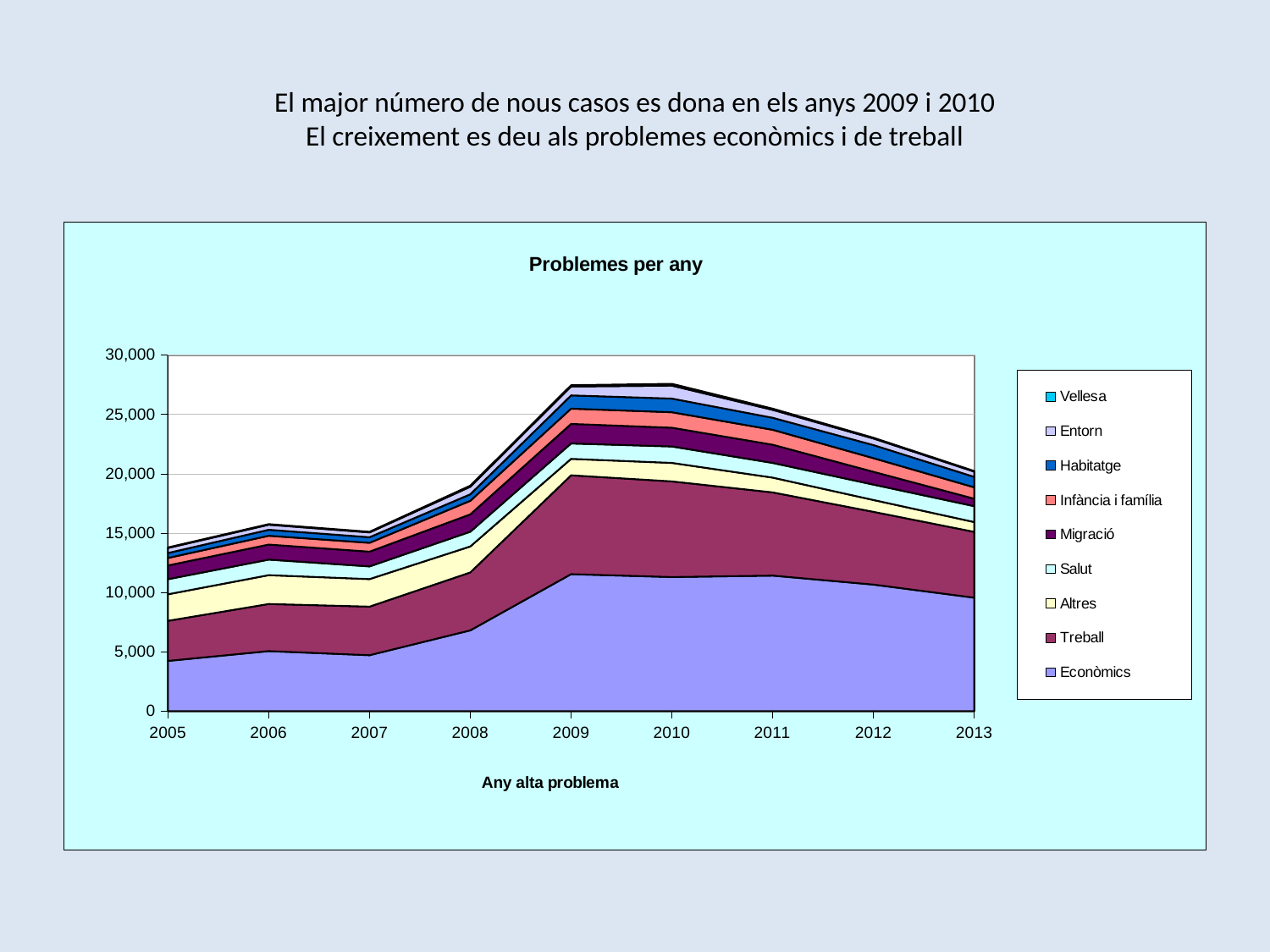
Is the total of all problems in 2013 greater or less than 25,000? less What kind of chart is shown on the slide? Stacked area chart Is the total of all problems in 2009 greater or less than 25,000? greater What is the title of the chart? Problemes per any Does the total number of problems rise or fall from 2010 to 2013? fall Is the value for Econòmics in 2005 greater or less than 5,000? less Does the total number of problems rise or fall from 2007 to 2009? rise How many series does the legend list? 9 How many years are shown along the x axis? 9 What is the x-axis title of the chart? Any alta problema